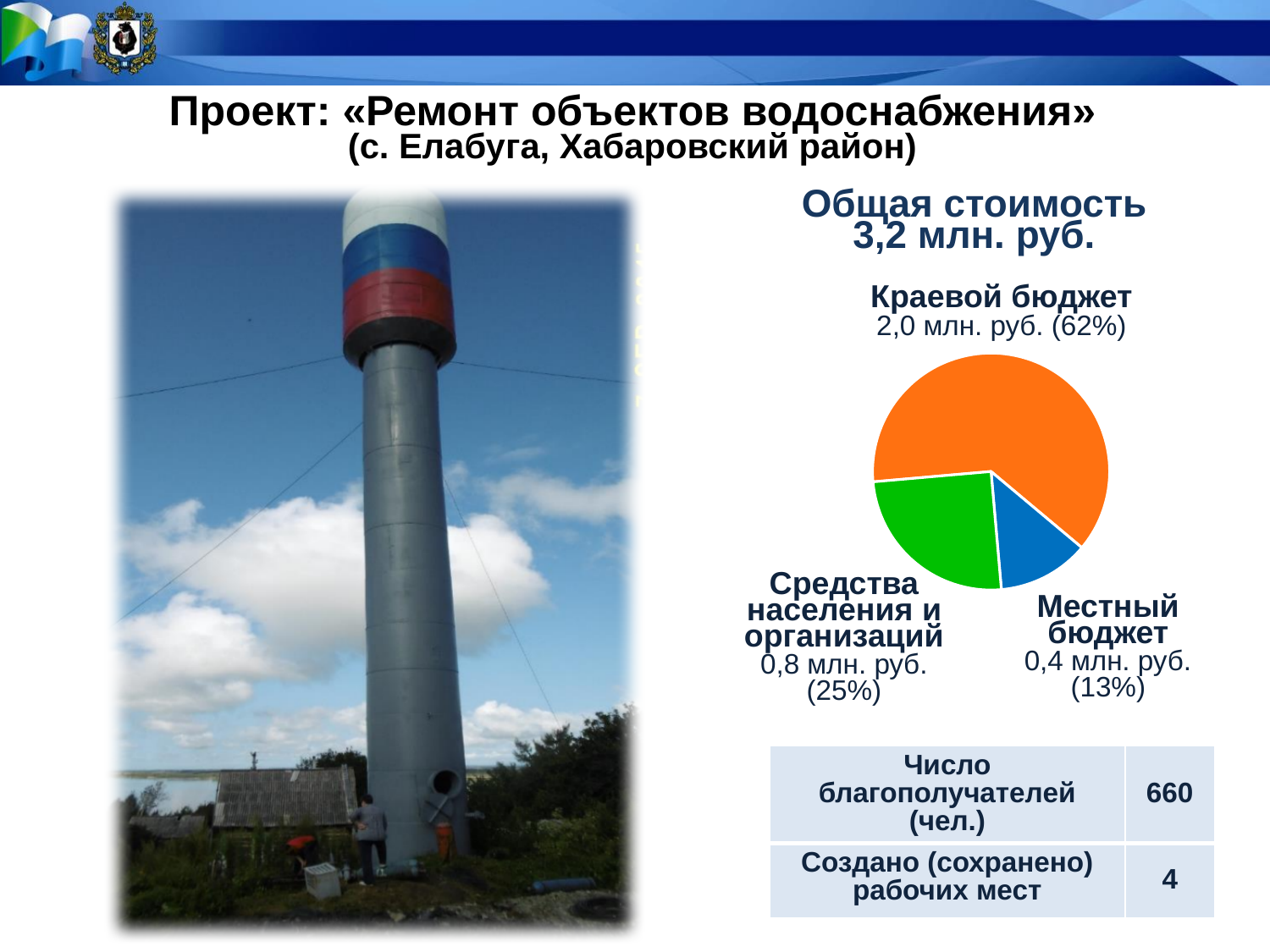
What share of the pie does Краевой бюджет represent? 62% What is the value for Местный бюджет in the pie chart? 0,4 млн. руб. Which is larger in the pie chart: Средства населения и организаций or Местный бюджет? Средства населения и организаций What is the difference in percentage points between the Краевой бюджет share and the Местный бюджет share? 49 What kind of chart is shown on the slide? pie chart What is the value for Средства населения и организаций in the pie chart? 0,8 млн. руб. How many slices does the pie chart have? 3 Which slice of the pie chart is the smallest? Местный бюджет What share of the pie does Местный бюджет represent? 13% What is the value for Краевой бюджет in the pie chart? 2,0 млн. руб. Which slice of the pie chart is the largest? Краевой бюджет What colour is the Краевой бюджет slice in the pie chart? orange